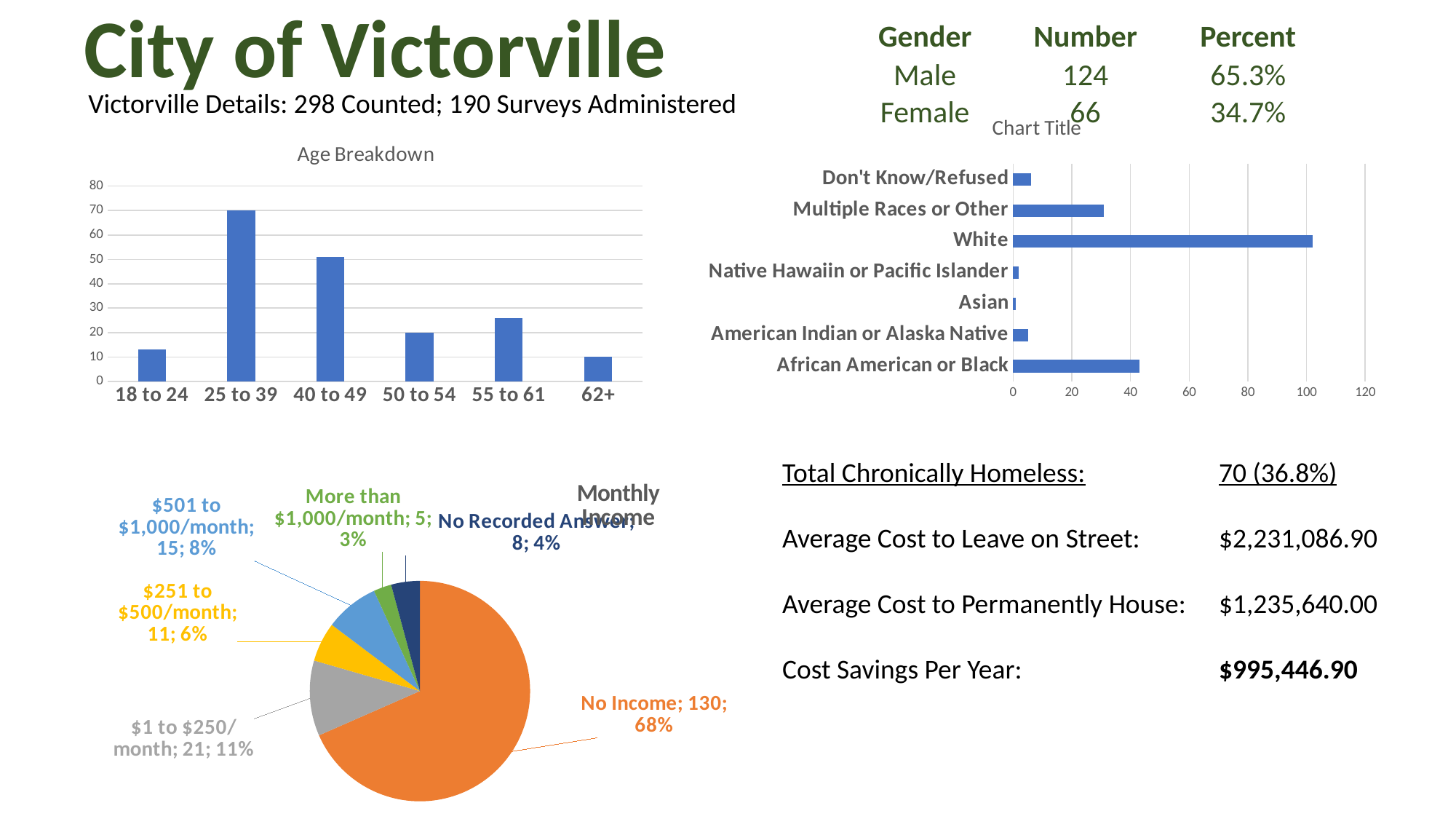
In the Age Breakdown chart, which age group has the lowest bar? 62+ In the Monthly Income pie chart, what is the difference between the values for $501 to $1,000/month and $251 to $500/month? 4 In the Age Breakdown chart, is the value for 18 to 24 greater or less than 20? less In the Age Breakdown chart, which age group has the highest bar? 25 to 39 In the Age Breakdown chart, how many age groups are shown? 6 In the Age Breakdown chart, is the value for 40 to 49 greater or less than 40? greater In the Age Breakdown chart, which is larger, the value for 55 to 61 or the value for 50 to 54? 55 to 61 In the horizontal bar chart titled Chart Title, is the value for African American or Black greater or less than 40? greater In the horizontal bar chart titled Chart Title, how many categories are listed? 7 In the horizontal bar chart titled Chart Title, which category has the longest bar? White In the Monthly Income pie chart, what share of the pie is $1 to $250/month? 11% In the Monthly Income pie chart, what is the value for No Income? 130